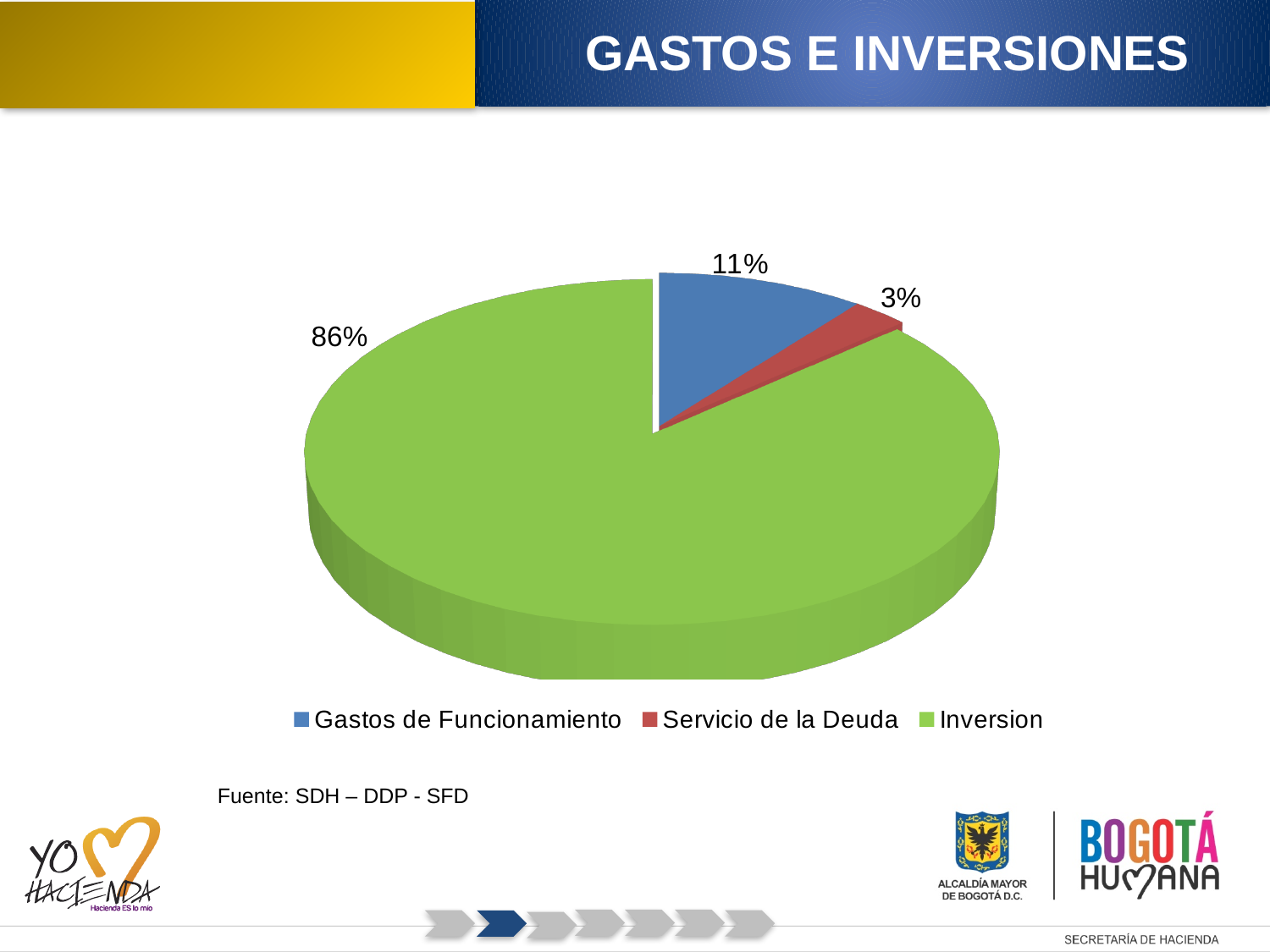
Which is larger, Gastos de Funcionamiento or Servicio de la Deuda? Gastos de Funcionamiento Which category has the smallest slice of the pie? Servicio de la Deuda What share of the pie does Inversion represent? 86% What kind of chart is shown on the slide? pie chart What share of the pie does Gastos de Funcionamiento represent? 11% What is the difference in percentage points between Inversion and Gastos de Funcionamiento? 75 Which category has the largest slice of the pie? Inversion What is the difference in percentage points between Gastos de Funcionamiento and Servicio de la Deuda? 8 What colour is the Inversion slice? green How many entries does the legend list? 3 How many categories does the pie chart show? 3 What share of the pie does Servicio de la Deuda represent? 3%